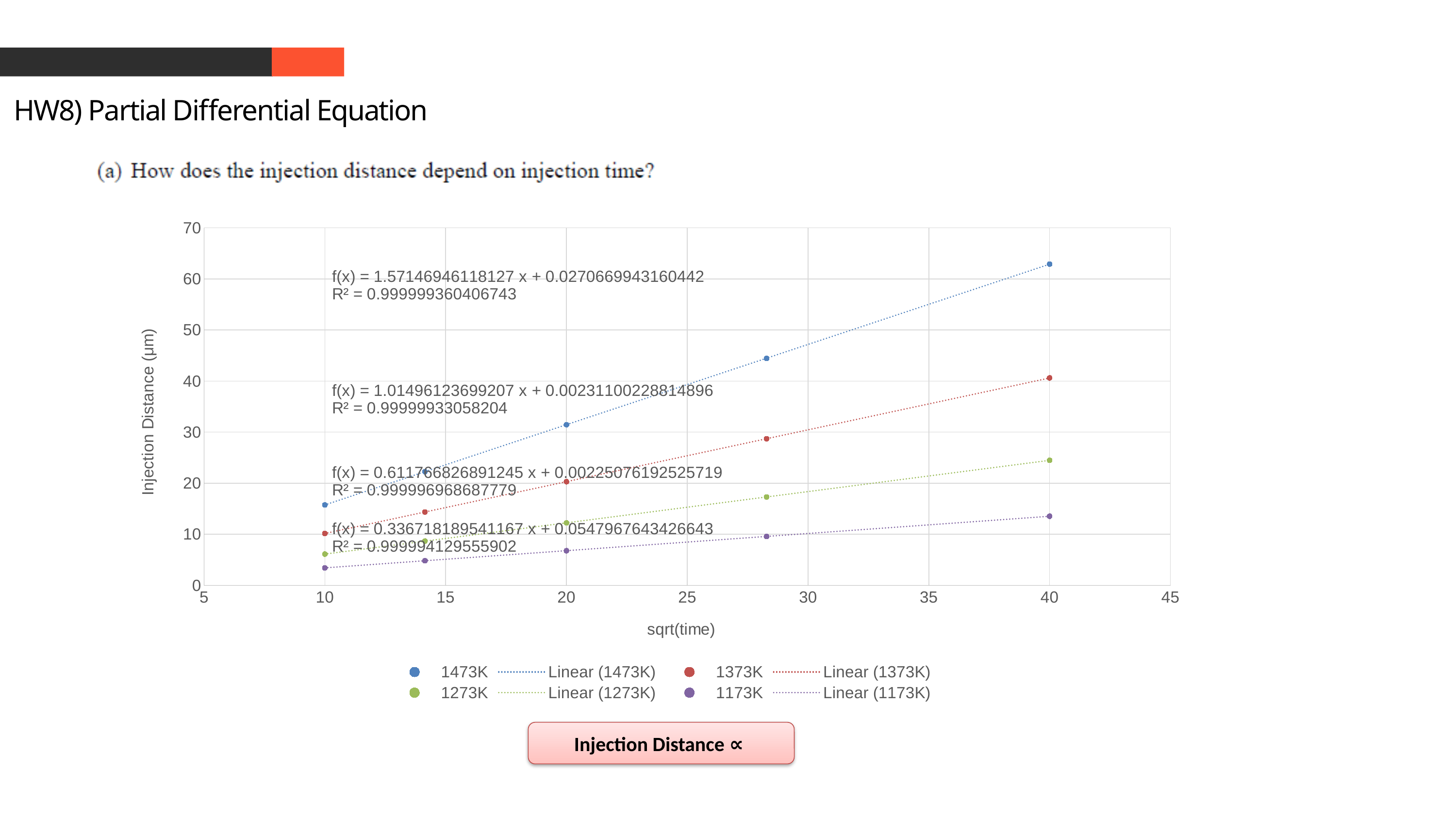
Which series has the lowest injection distance at sqrt(time) = 40? 1173K Is the injection distance for 1173K at sqrt(time) = 40 greater or less than 20? less What kind of chart is shown on the slide? scatter chart What is the label of the x axis of the chart? sqrt(time) What is the slope (coefficient of x) in the topmost trendline equation shown on the chart? 1.57146946118127 How many temperature series (data point series) are plotted in the chart? 4 Is the injection distance for 1473K at sqrt(time) = 40 greater or less than 60? greater How many data points are plotted for the 1473K series? 5 Is the injection distance for 1273K at sqrt(time) = 40 greater or less than 30? less At sqrt(time) = 40, which series has the larger injection distance, 1373K or 1273K? 1373K Do the injection distance values rise or fall as sqrt(time) increases? rise Which series has the highest injection distance at sqrt(time) = 40? 1473K